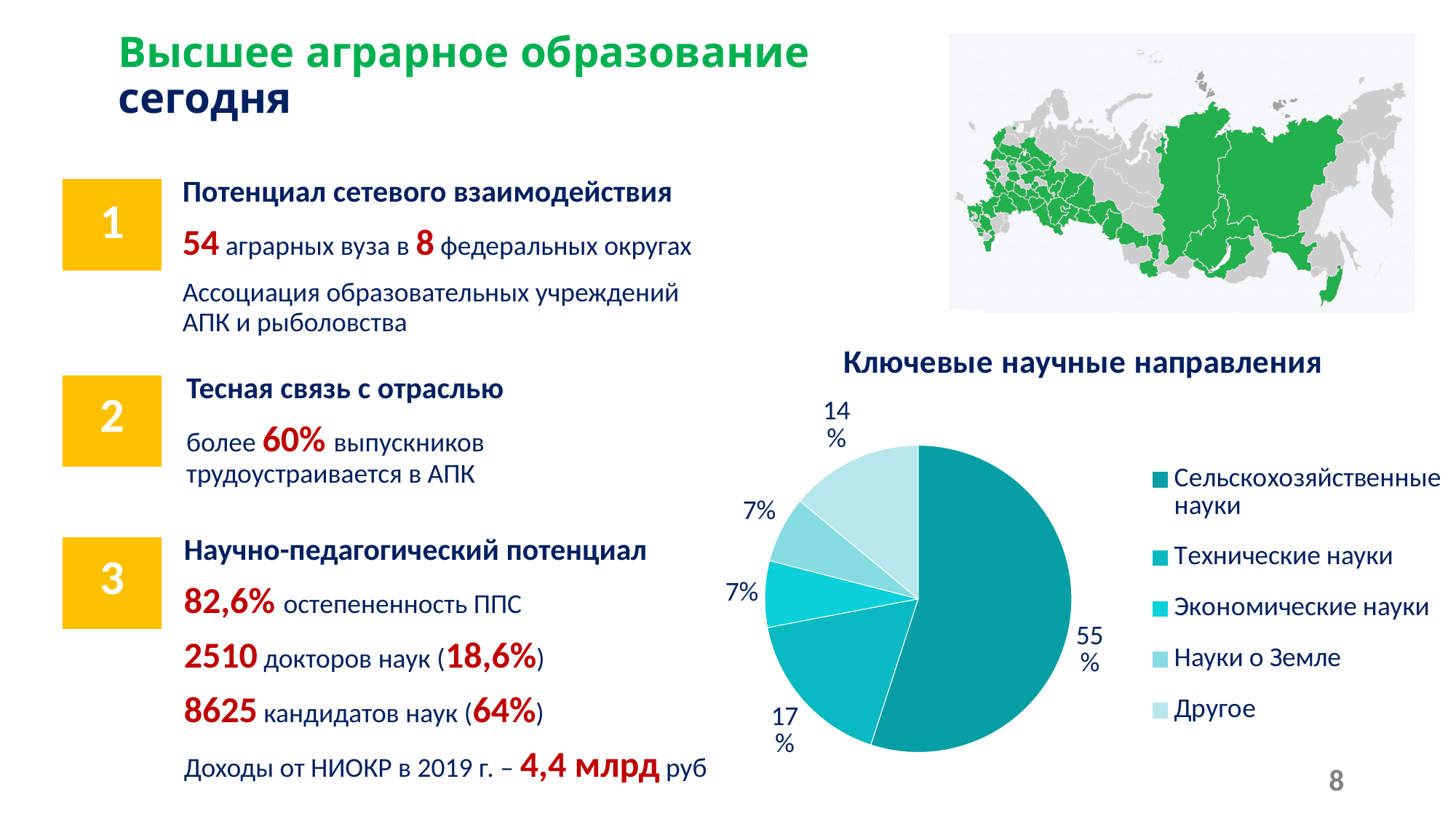
What is the title of the pie chart on the slide? Ключевые научные направления How many entries does the legend of the pie chart "Ключевые научные направления" list? 5 In the pie chart "Ключевые научные направления", what share is shown for Другое? 14% In the pie chart "Ключевые научные направления", what is the difference in percentage points between Другое and Науки о Земле? 7 What kind of chart is shown under the title "Ключевые научные направления"? pie chart In the pie chart "Ключевые научные направления", what share is shown for Экономические науки? 7% In the pie chart "Ключевые научные направления", what is the difference in percentage points between Сельскохозяйственные науки and Технические науки? 38 How many slices does the pie chart "Ключевые научные направления" have? 5 In the pie chart "Ключевые научные направления", what share is shown for Технические науки? 17% In the pie chart "Ключевые научные направления", what share is shown for Сельскохозяйственные науки? 55% In the pie chart "Ключевые научные направления", which is larger: Технические науки or Другое? Технические науки In the pie chart "Ключевые научные направления", which category has the largest share? Сельскохозяйственные науки